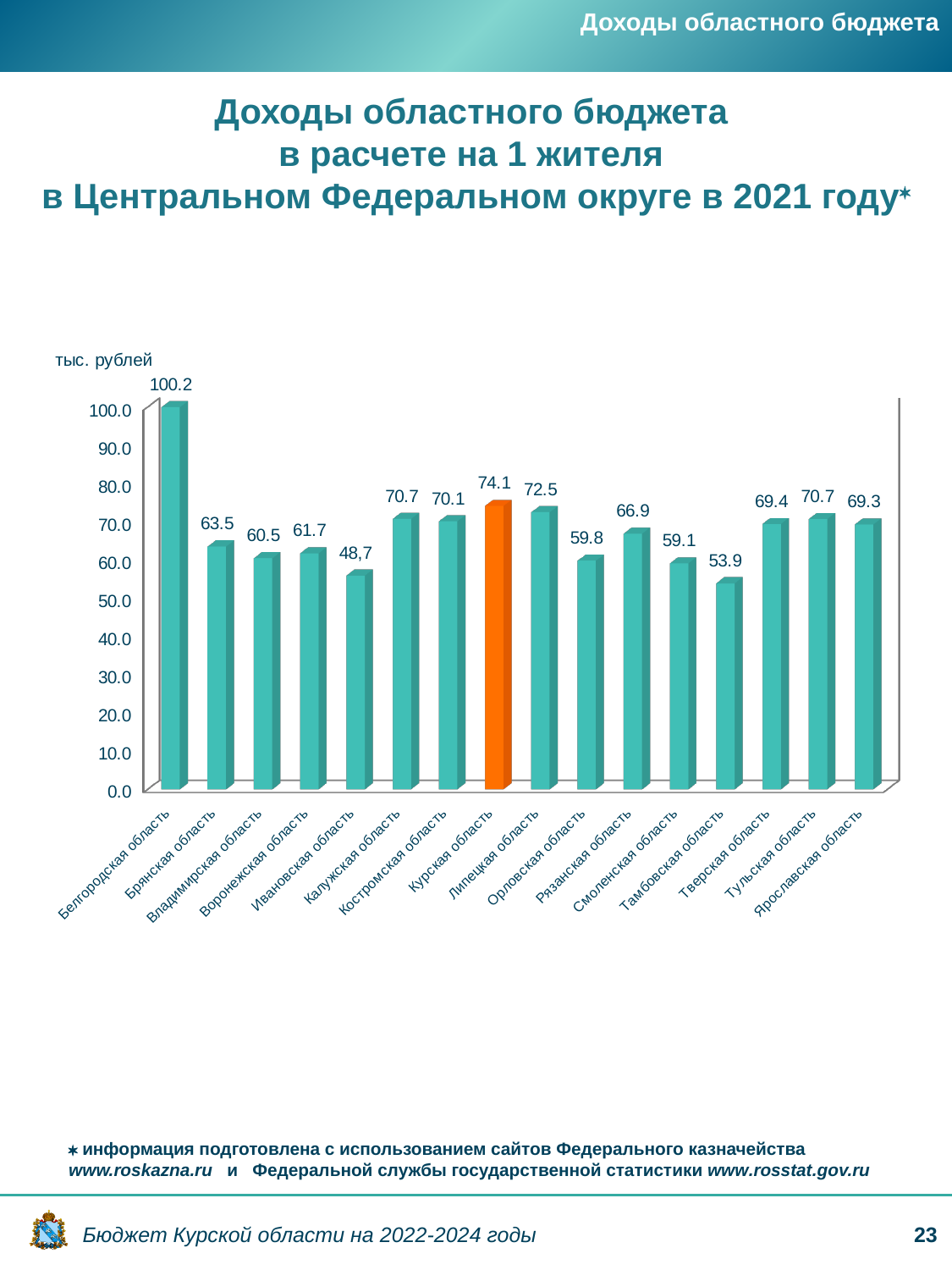
What is the value for Курская область? 74.1 What is the value for Ивановская область? 48,7 How many regions are shown on the chart? 16 What kind of chart is shown on the slide? bar chart Which is larger, the value for Липецкая область or the value for Рязанская область? Липецкая область What unit is indicated on the chart's axis? тыс. рублей Which region has the highest value? Белгородская область What is the difference between the values for Белгородская область and Курская область? 26.1 What is the value for Тамбовская область? 53.9 Which region's bar is highlighted in orange? Курская область Is the value for Смоленская область greater or less than 60.0? less